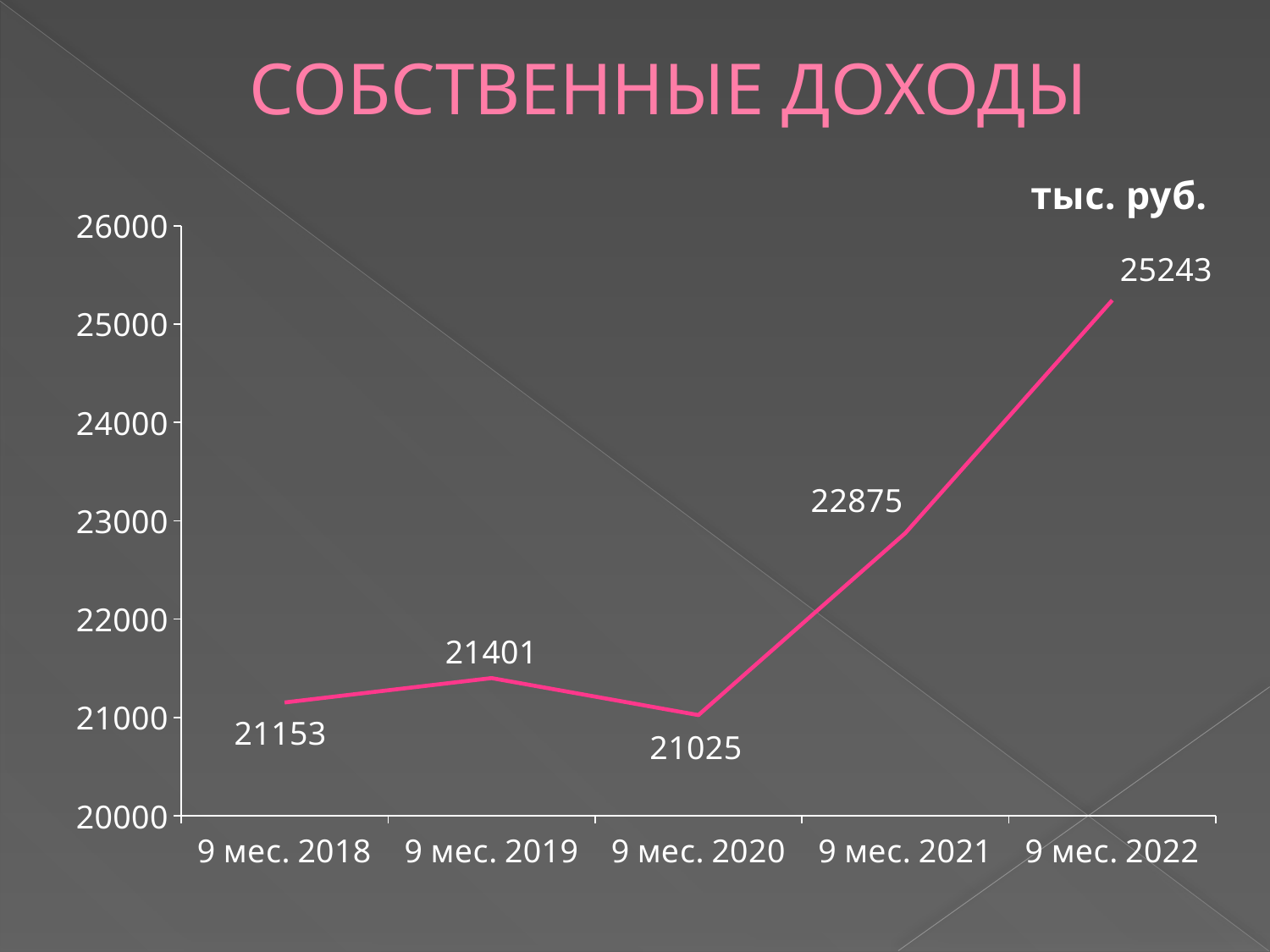
What is the difference between the values for 9 мес. 2019 and 9 мес. 2018? 248 What kind of chart is shown on the slide? line chart What is the title of the chart? СОБСТВЕННЫЕ ДОХОДЫ What is the value for 9 мес. 2018? 21153 How many periods are plotted on the chart? 5 Which period has the lowest value? 9 мес. 2020 What is the difference between the values for 9 мес. 2022 and 9 мес. 2021? 2368 Which is larger, the value for 9 мес. 2021 or the value for 9 мес. 2019? 9 мес. 2021 Which period has the highest value? 9 мес. 2022 What is the value for 9 мес. 2020? 21025 Is the value for 9 мес. 2021 greater or less than 22000? greater What is the value for 9 мес. 2022? 25243